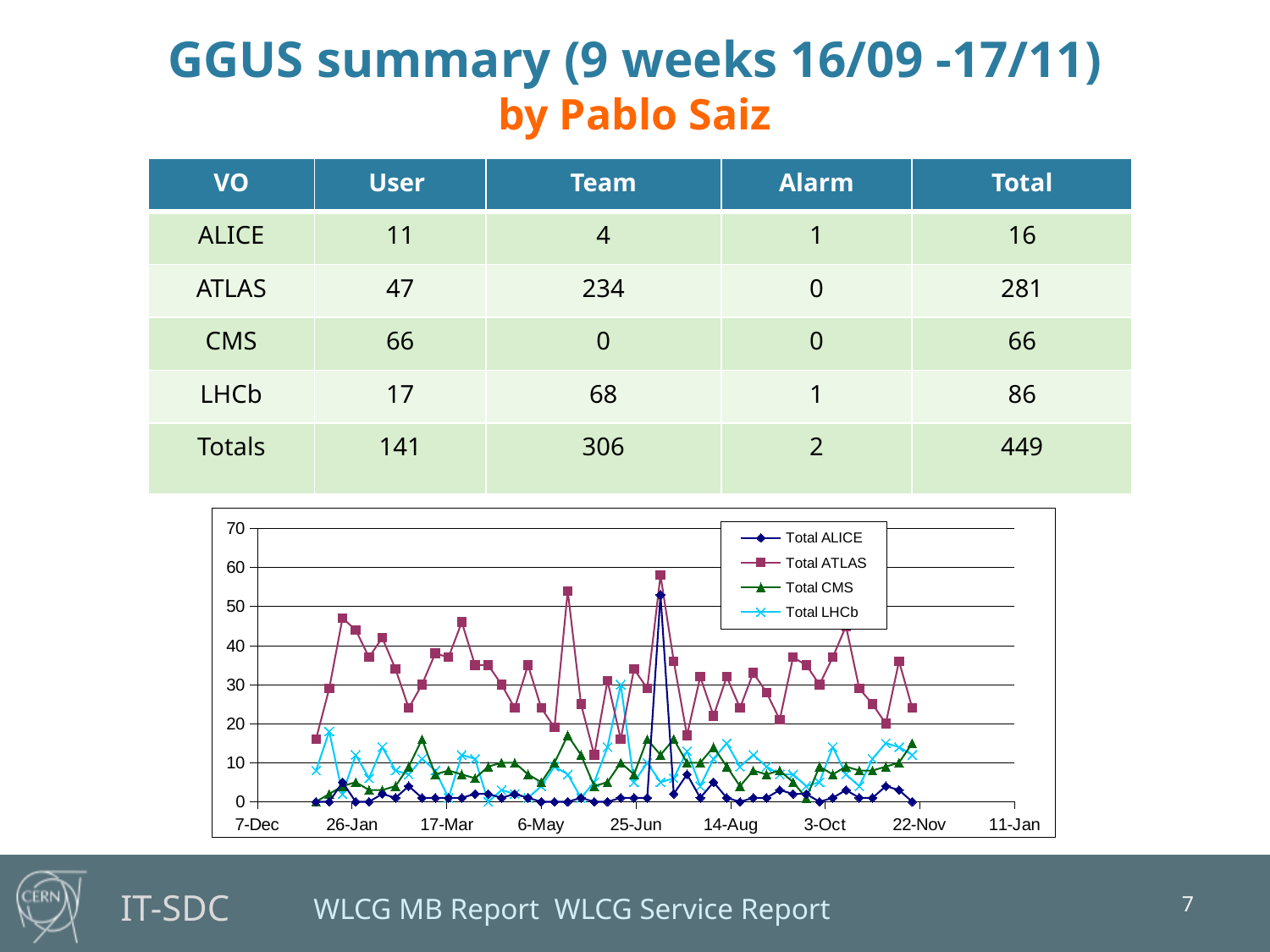
How many date labels are shown on the x axis of the chart? 9 Which series reaches the highest value on the chart? Total ATLAS Is the first plotted value for Total ATLAS (near 26-Jan) greater or less than 20? less Is the highest value for Total ALICE greater or less than 40? greater What is the maximum value shown on the chart's y axis? 70 Is the highest value for Total CMS greater or less than 20? less Which series stays lowest for most of the period shown? Total ALICE What kind of chart is shown on the slide? Line chart Which marker shape is used for the Total CMS series? Triangles How many series does the chart legend list? 4